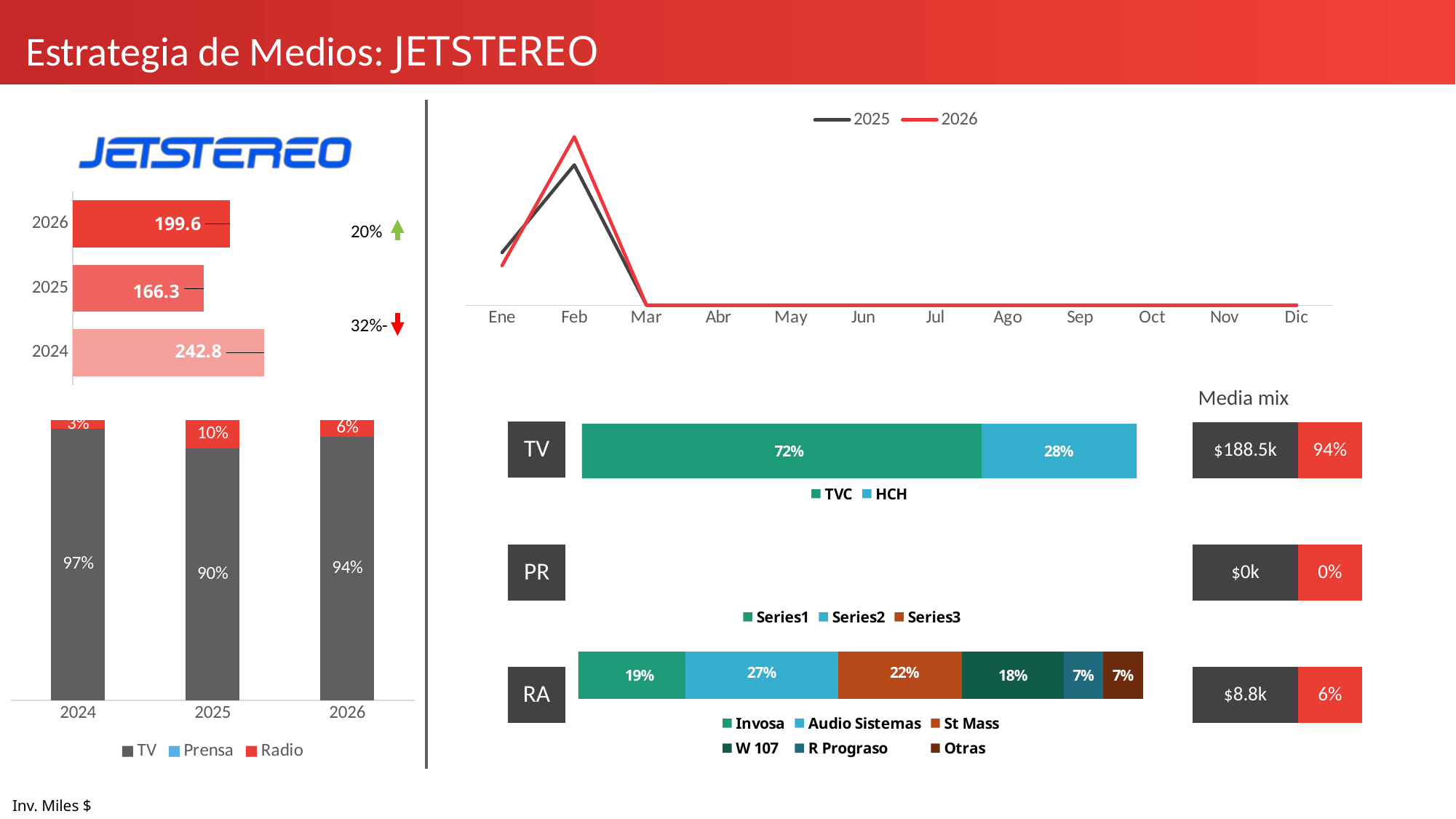
How many series does the legend of the stacked bar chart at the bottom left list? 3 In the horizontal bar chart of yearly investment on the left, what is the difference between the 2026 and 2025 values? 33.3 In the horizontal bar chart of yearly investment on the left, which year has the lowest value? 2025 In the stacked bar chart at the bottom left, what is the TV share for 2025? 90% In the horizontal bar chart of yearly investment on the left, which year has the highest value? 2024 In the Media mix column on the right, what is the dollar value shown for RA? $8.8k In the RA stacked bar on the right, which category has the largest share? Audio Sistemas In the stacked bar chart at the bottom left, what is the Radio share for 2024? 3% In the TV stacked bar on the right, what is the share for HCH? 28% In the horizontal bar chart of yearly investment on the left, what is the value for 2026? 199.6 In the line chart at the top right, in which month do both lines reach their peak? Feb How many series does the legend of the line chart at the top right list? 2